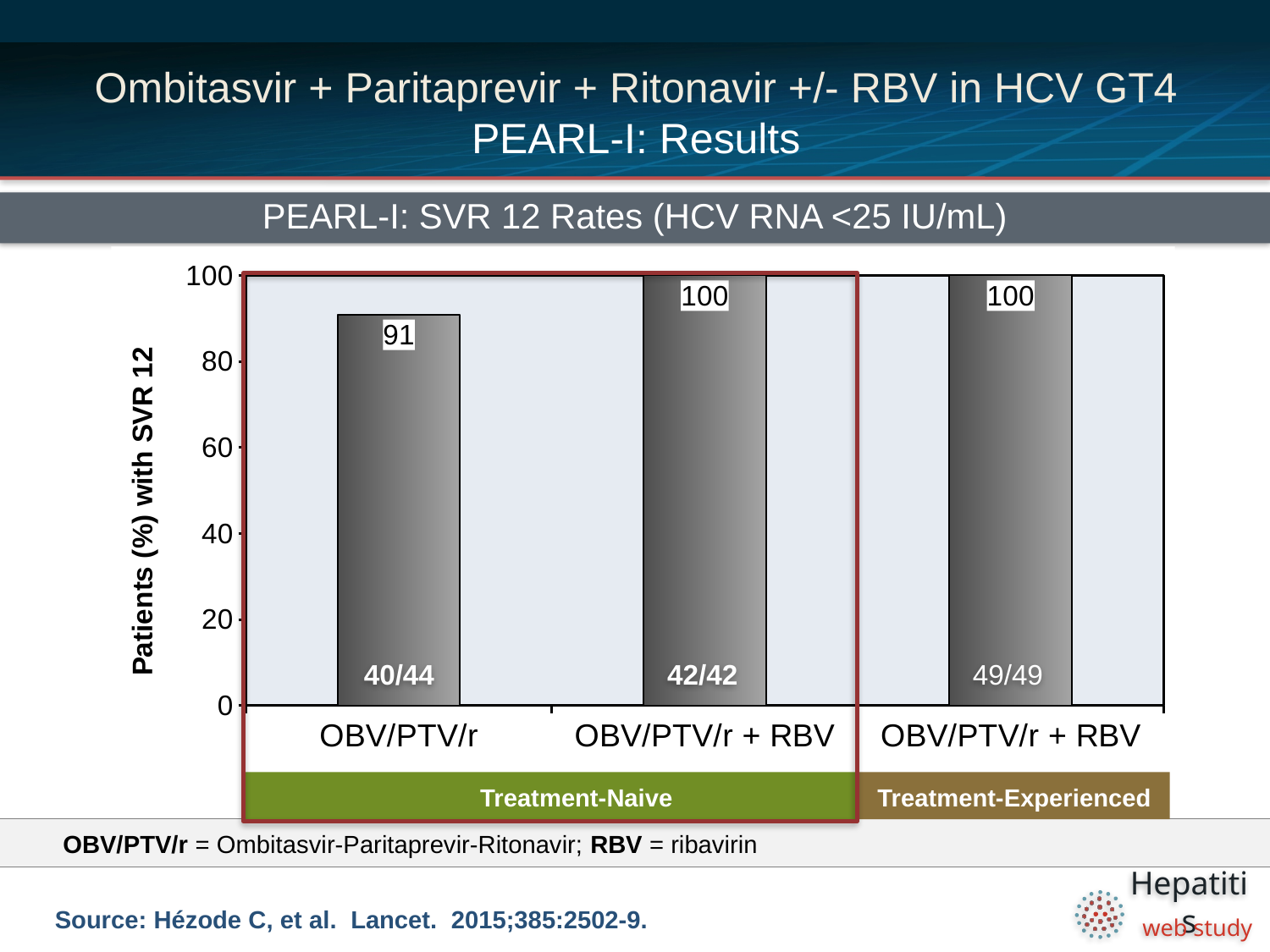
What is the label of the y-axis? Patients (%) with SVR 12 What is the difference in SVR 12 rate between OBV/PTV/r + RBV and OBV/PTV/r in the Treatment-Naive group? 9 How many bars are shown in the chart? 3 What is the SVR 12 rate for OBV/PTV/r + RBV in the Treatment-Experienced group? 100 Which has a higher SVR 12 rate in the Treatment-Naive group: OBV/PTV/r or OBV/PTV/r + RBV? OBV/PTV/r + RBV How many patients achieved SVR 12 out of the total in the OBV/PTV/r Treatment-Naive arm? 40/44 How many patients achieved SVR 12 out of the total in the OBV/PTV/r + RBV Treatment-Experienced arm? 49/49 Which treatment arm has the lowest SVR 12 rate? OBV/PTV/r (Treatment-Naive) What is the SVR 12 rate for OBV/PTV/r + RBV in the Treatment-Naive group? 100 What is the SVR 12 rate for OBV/PTV/r in the Treatment-Naive group? 91 What is the title of the chart? PEARL-I: SVR 12 Rates (HCV RNA <25 IU/mL) What type of chart is shown on the slide? Bar chart